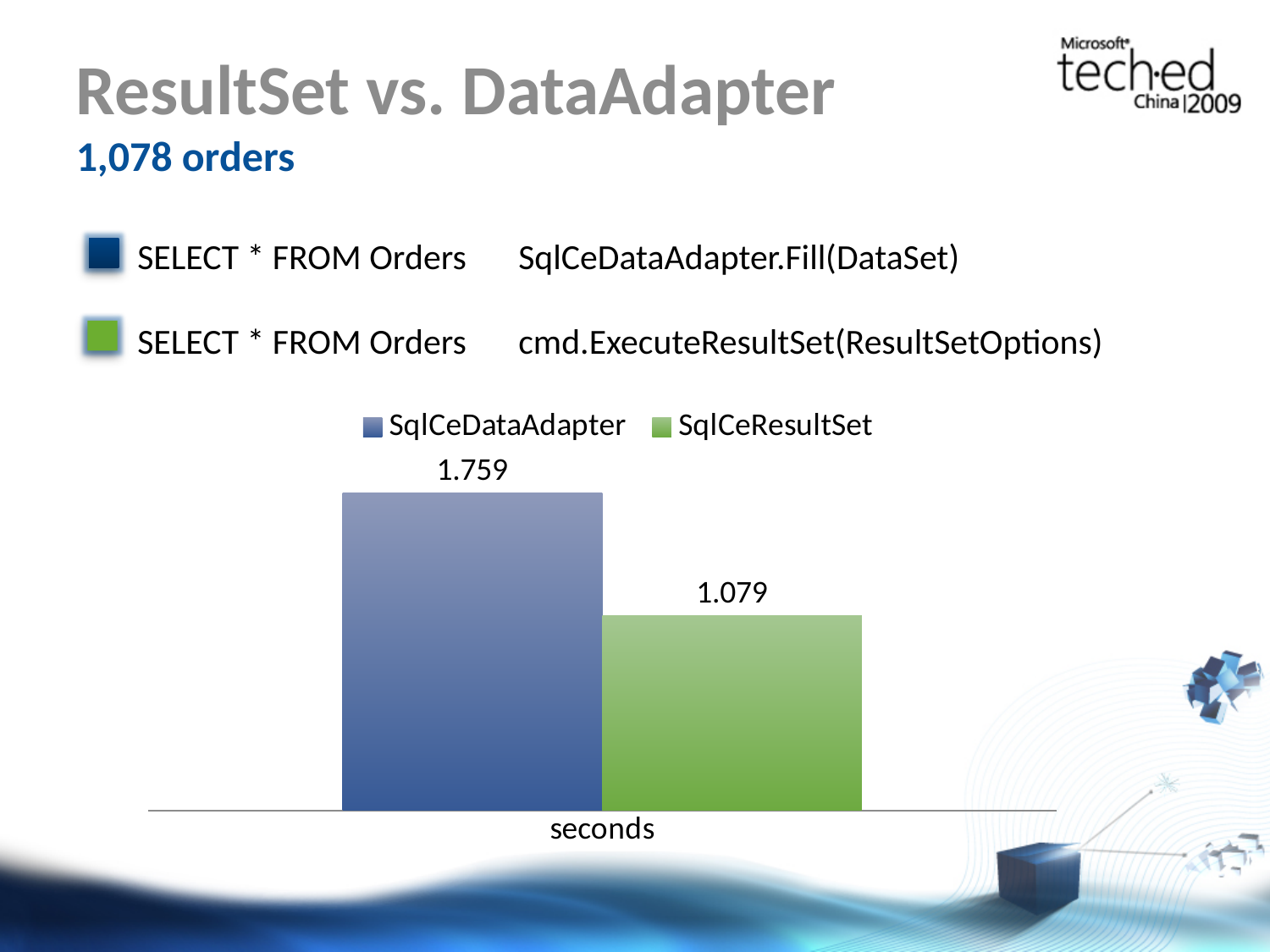
What is the label on the x axis of the chart? seconds What is the value for SqlCeResultSet in the chart? 1.079 Which series has the lower value in the chart? SqlCeResultSet What kind of chart is shown on the slide? bar chart What is the difference between the SqlCeDataAdapter and SqlCeResultSet values? 0.680 How many series does the chart legend list? 2 How many bars are plotted in the chart? 2 Which series has the higher value in the chart? SqlCeDataAdapter What colour is the SqlCeResultSet bar in the chart? green What is the value for SqlCeDataAdapter in the chart? 1.759 Is the value for SqlCeDataAdapter larger or smaller than the value for SqlCeResultSet? larger